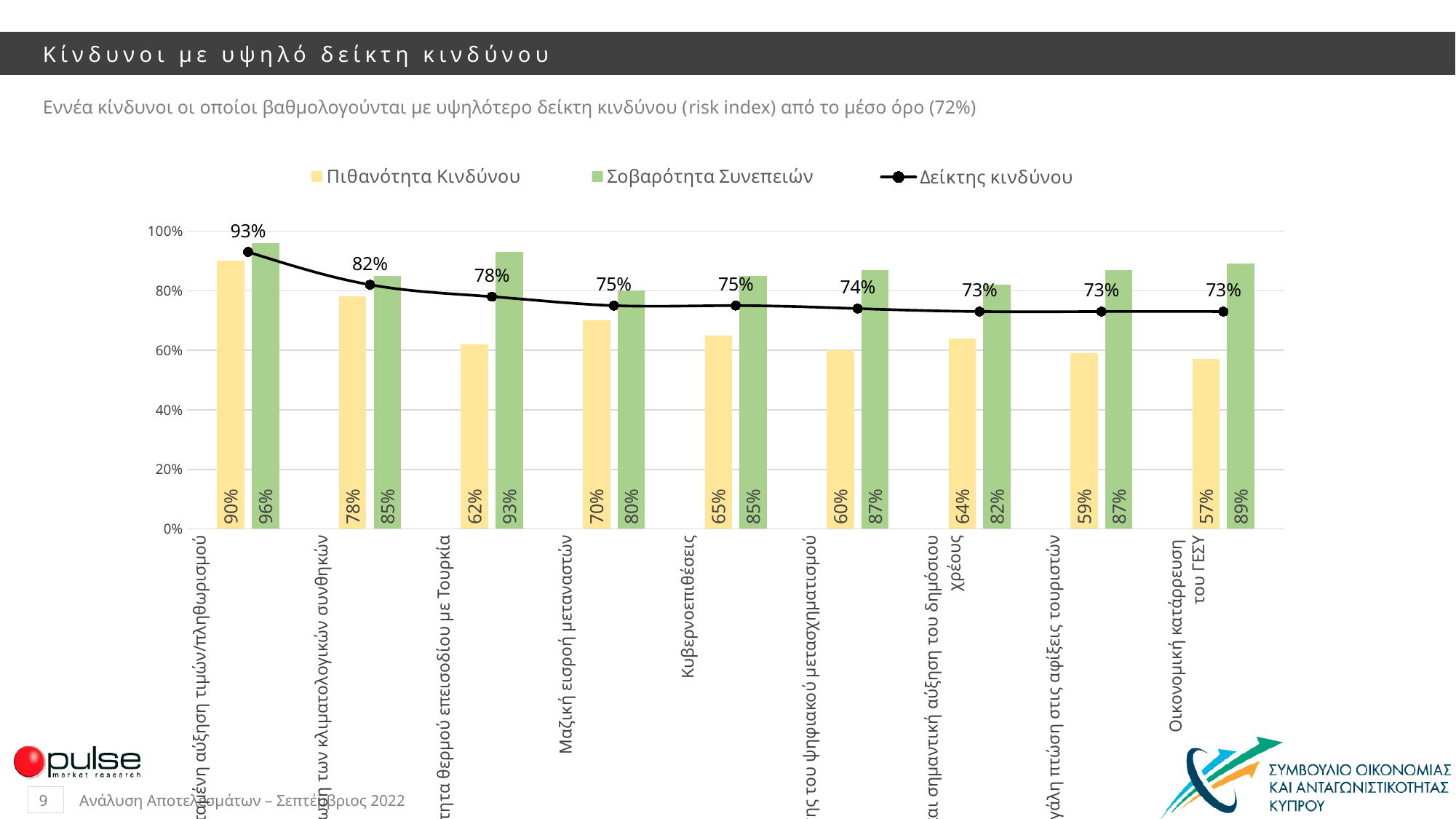
How many risk categories are plotted on the chart? 9 What kind of chart is shown on the slide? bar chart with a line series Does the Δείκτης κινδύνου line rise or fall from left to right across the categories? fall What is the highest value shown for the Δείκτης κινδύνου line? 93% What is the Δείκτης κινδύνου value for Οικονομική κατάρρευση του ΓΕΣΥ? 73% Which is larger for Μαζική εισροή μεταναστών: Πιθανότητα Κινδύνου or Σοβαρότητα Συνεπειών? Σοβαρότητα Συνεπειών Which category has the lowest Πιθανότητα Κινδύνου value? Οικονομική κατάρρευση του ΓΕΣΥ What is the value of Πιθανότητα Κινδύνου for Κυβερνοεπιθέσεις? 65% How many series does the legend list? 3 What is the difference between Σοβαρότητα Συνεπειών and Πιθανότητα Κινδύνου for Κυβερνοεπιθέσεις? 20 percentage points What is the value of Σοβαρότητα Συνεπειών for Μαζική εισροή μεταναστών? 80% What is the value of Σοβαρότητα Συνεπειών for Οικονομική κατάρρευση του ΓΕΣΥ? 89%